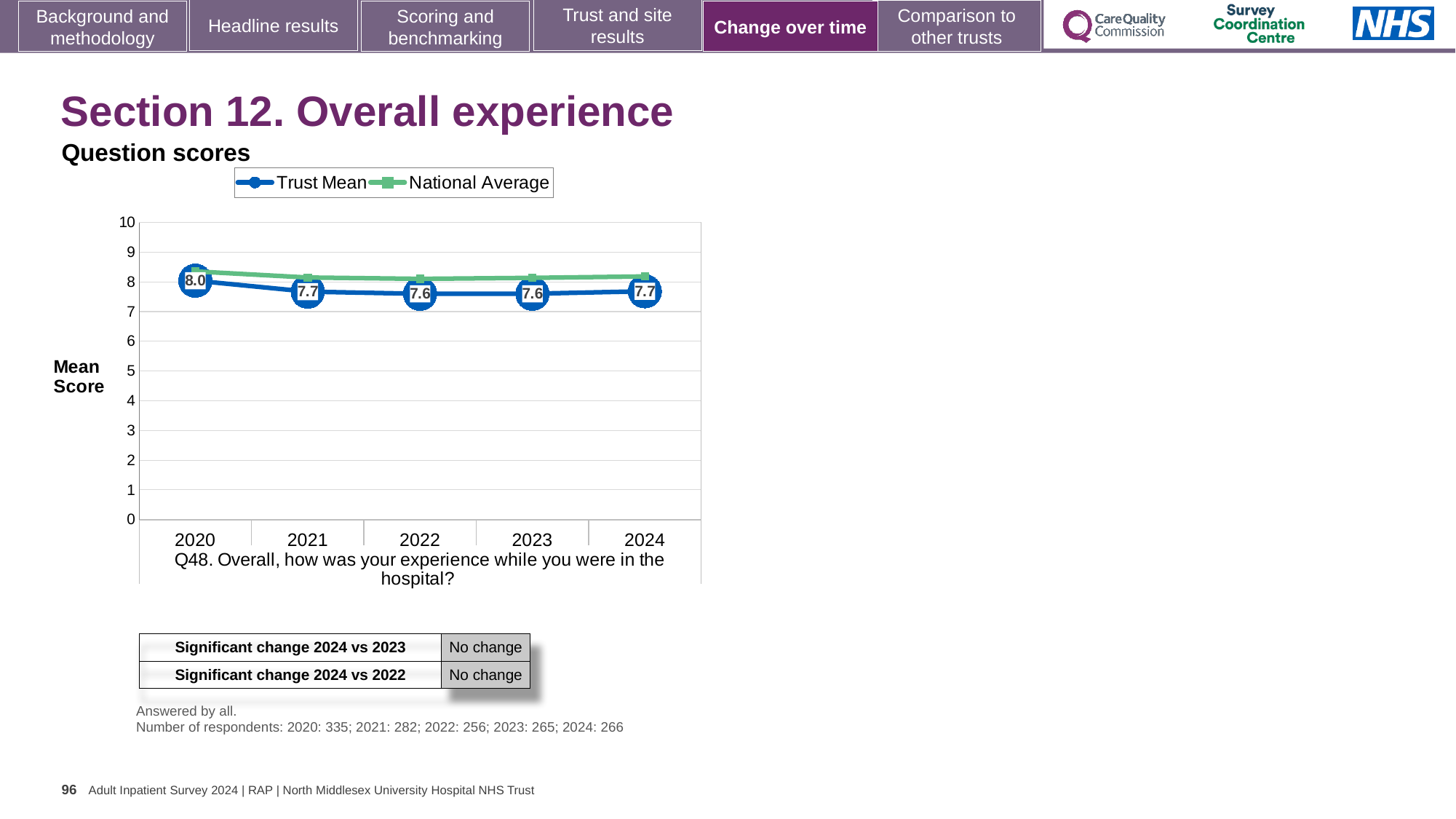
How many years are plotted on the x axis? 5 What is the difference between the Trust Mean score in 2020 and in 2021? 0.3 Does the Trust Mean score rise or fall from 2020 to 2022? Fall Is the National Average value for 2020 greater or less than 8? greater What is the Trust Mean score for 2020? 8.0 What kind of chart is shown on the slide? Line chart Which is larger, the Trust Mean score in 2020 or in 2024? 2020 In which year is the Trust Mean score highest? 2020 What is the label on the y axis of the chart? Mean Score How many series does the legend list? 2 What is the Trust Mean score for 2022? 7.6 What is the Trust Mean score for 2024? 7.7